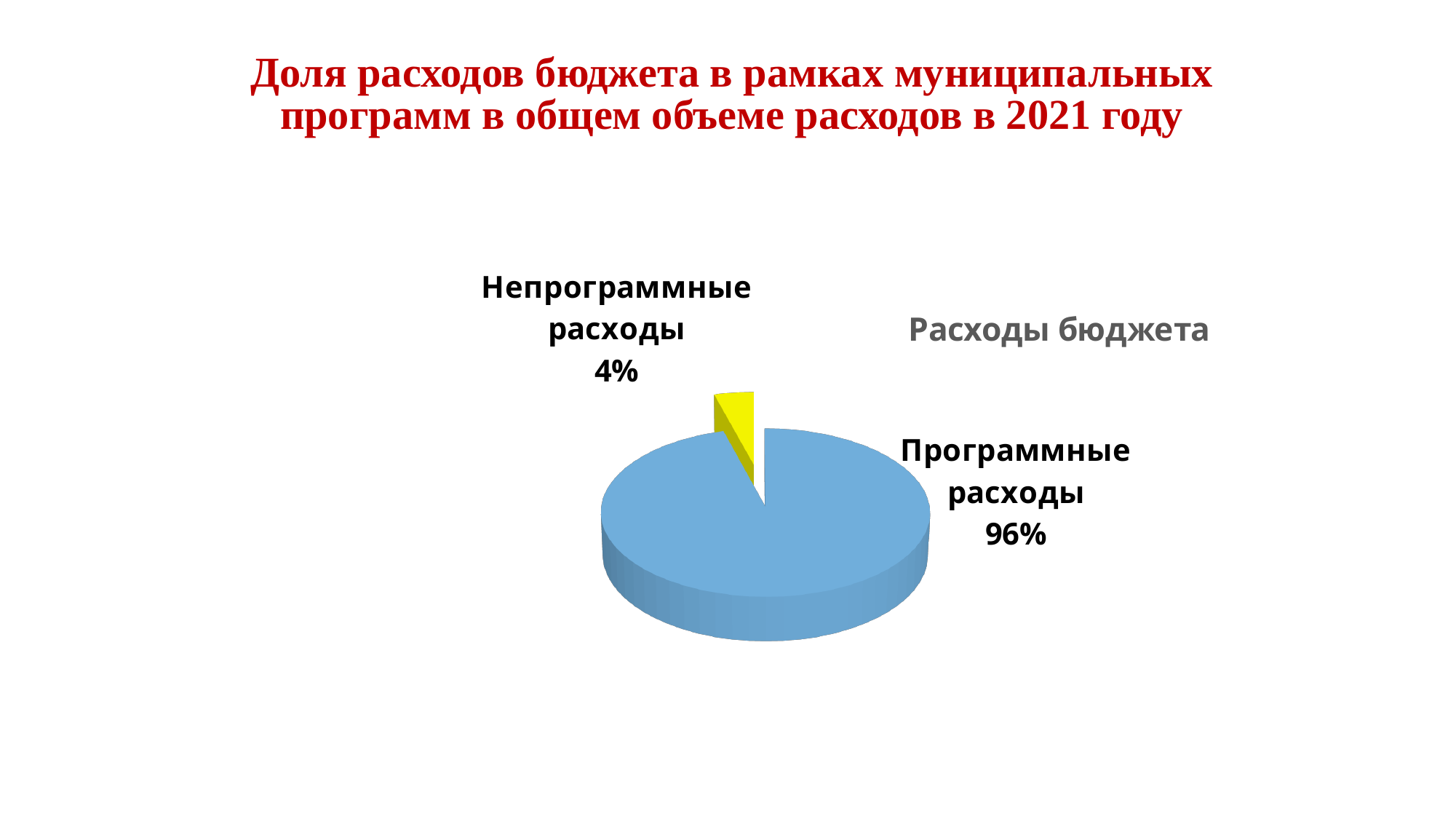
What is the title shown inside the chart area? Расходы бюджета What share of the pie is labelled "Программные расходы"? 96% How many slices does the pie chart have? 2 What share of the pie is labelled "Непрограммные расходы"? 4% Which slice of the pie is the largest? Программные расходы Is the share for "Программные расходы" greater or less than 50%? greater Which slice of the pie is the smallest? Непрограммные расходы Which is larger: the "Программные расходы" slice or the "Непрограммные расходы" slice? Программные расходы What colour is the "Непрограммные расходы" slice? Yellow What is the difference in percentage points between the "Программные расходы" and "Непрограммные расходы" slices? 92 What kind of chart is shown on the slide? Pie chart